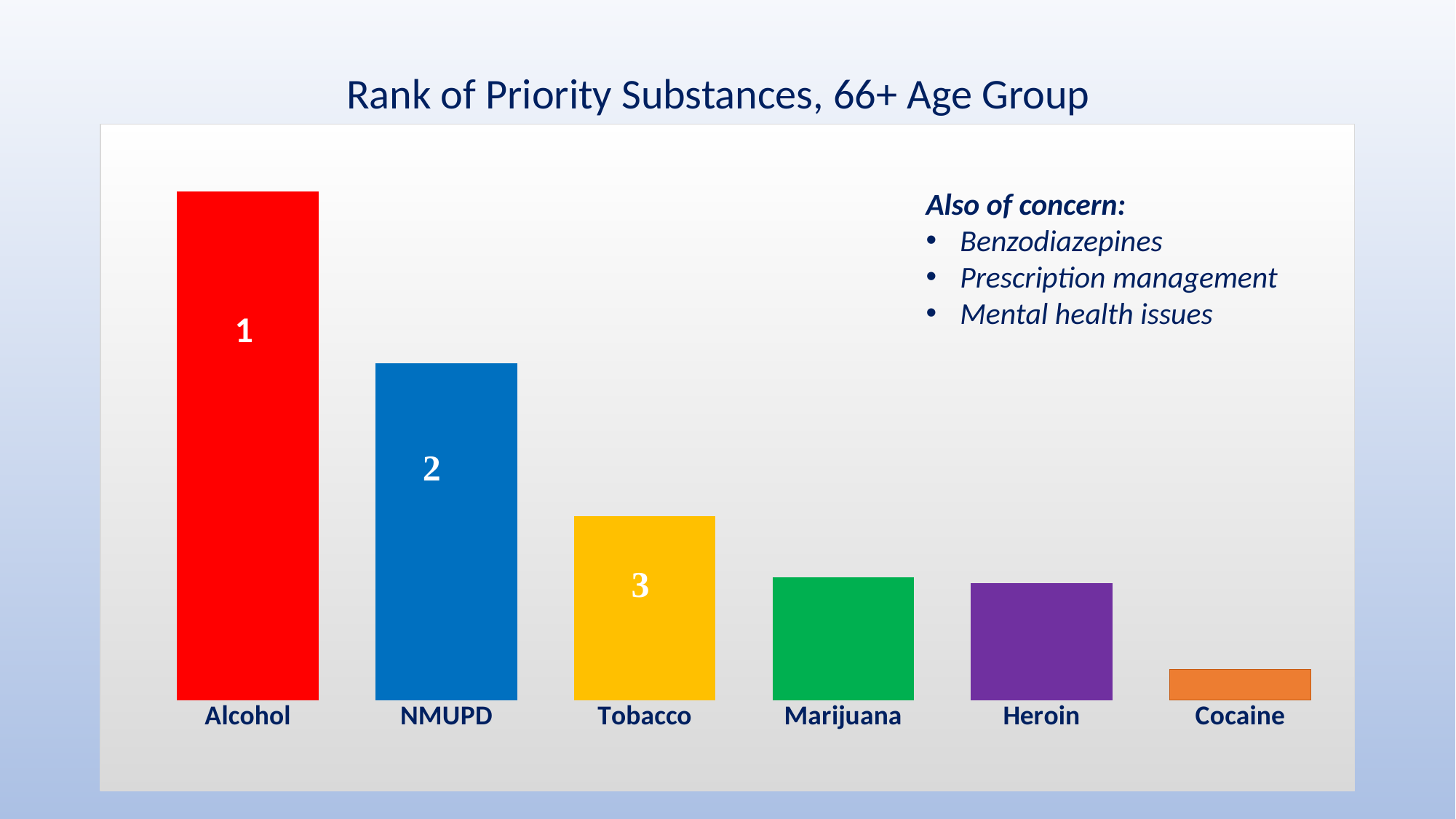
Do the bar heights rise or fall from left to right across the chart? Fall What rank label is printed on the Alcohol bar? 1 What is the title of the chart? Rank of Priority Substances, 66+ Age Group Which bar is taller, Alcohol or NMUPD? Alcohol Which substance has the tallest bar in the chart? Alcohol What rank label is printed on the NMUPD bar? 2 Which bar is taller, Tobacco or Cocaine? Tobacco What colour is the Alcohol bar? Red What rank label is printed on the Tobacco bar? 3 What kind of chart is shown on the slide? Bar chart How many substances (bars) are shown in the chart? 6 Which substance has the shortest bar in the chart? Cocaine